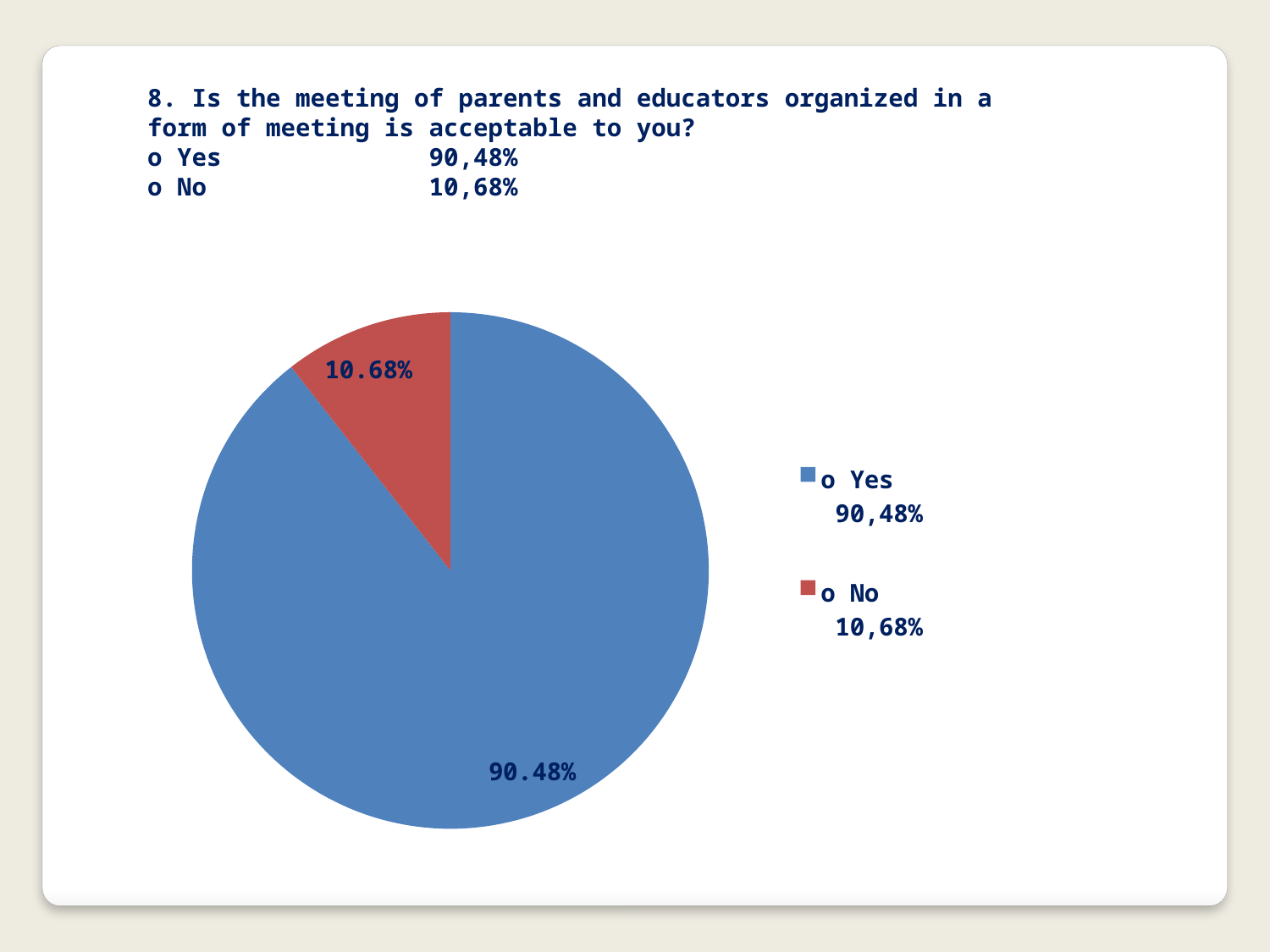
What percentage of the pie is labelled for the "o No" slice? 10.68% Which slice of the pie chart is the smallest? o No How many slices does the pie chart have? 2 What share of the pie does the "o No" slice represent? 10.68% By how many percentage points does the "o Yes" slice exceed the "o No" slice? 79.80 percentage points Which slice of the pie chart is the largest? o Yes What percentage of the pie is labelled for the "o Yes" slice? 90.48% How many entries does the legend list? 2 What kind of chart is shown on the slide? pie chart What colour is the "o Yes" slice in the pie chart? blue What colour is the "o No" slice in the pie chart? red Which is larger, the "o Yes" slice or the "o No" slice? o Yes